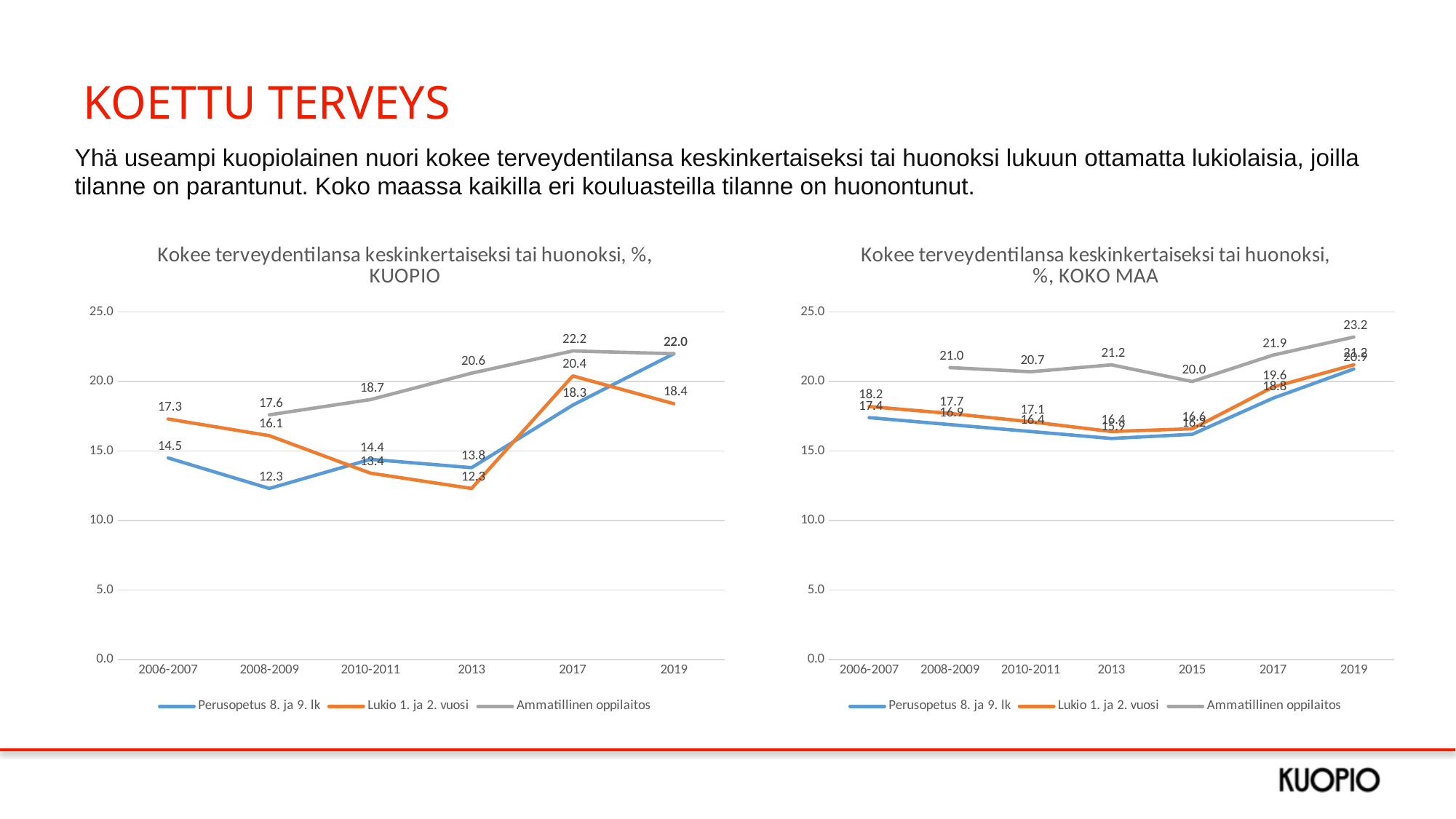
In the KUOPIO chart, in which period is the value for Perusopetus 8. ja 9. lk lowest? 2008-2009 In the KUOPIO chart, what is the value for Perusopetus 8. ja 9. lk in 2019? 22.0 How many periods are shown on the x axis of the KOKO MAA chart? 7 How many series does the legend of the KOKO MAA chart list? 3 What kind of chart is the left chart titled 'Kokee terveydentilansa keskinkertaiseksi tai huonoksi, %, KUOPIO'? Line chart In the KUOPIO chart, what is the difference between the Lukio 1. ja 2. vuosi values in 2017 and 2019? 2.0 In the KOKO MAA chart, what is the value for Ammatillinen oppilaitos in 2019? 23.2 In the KUOPIO chart, what is the value for Ammatillinen oppilaitos in 2017? 22.2 How many periods are shown on the x axis of the KUOPIO chart? 6 In the KOKO MAA chart, what is the value for Ammatillinen oppilaitos in 2015? 20.0 In the KOKO MAA chart, is the Ammatillinen oppilaitos value higher in 2015 or in 2017? 2017 In the KUOPIO chart, what is the value for Lukio 1. ja 2. vuosi in 2013? 12.3